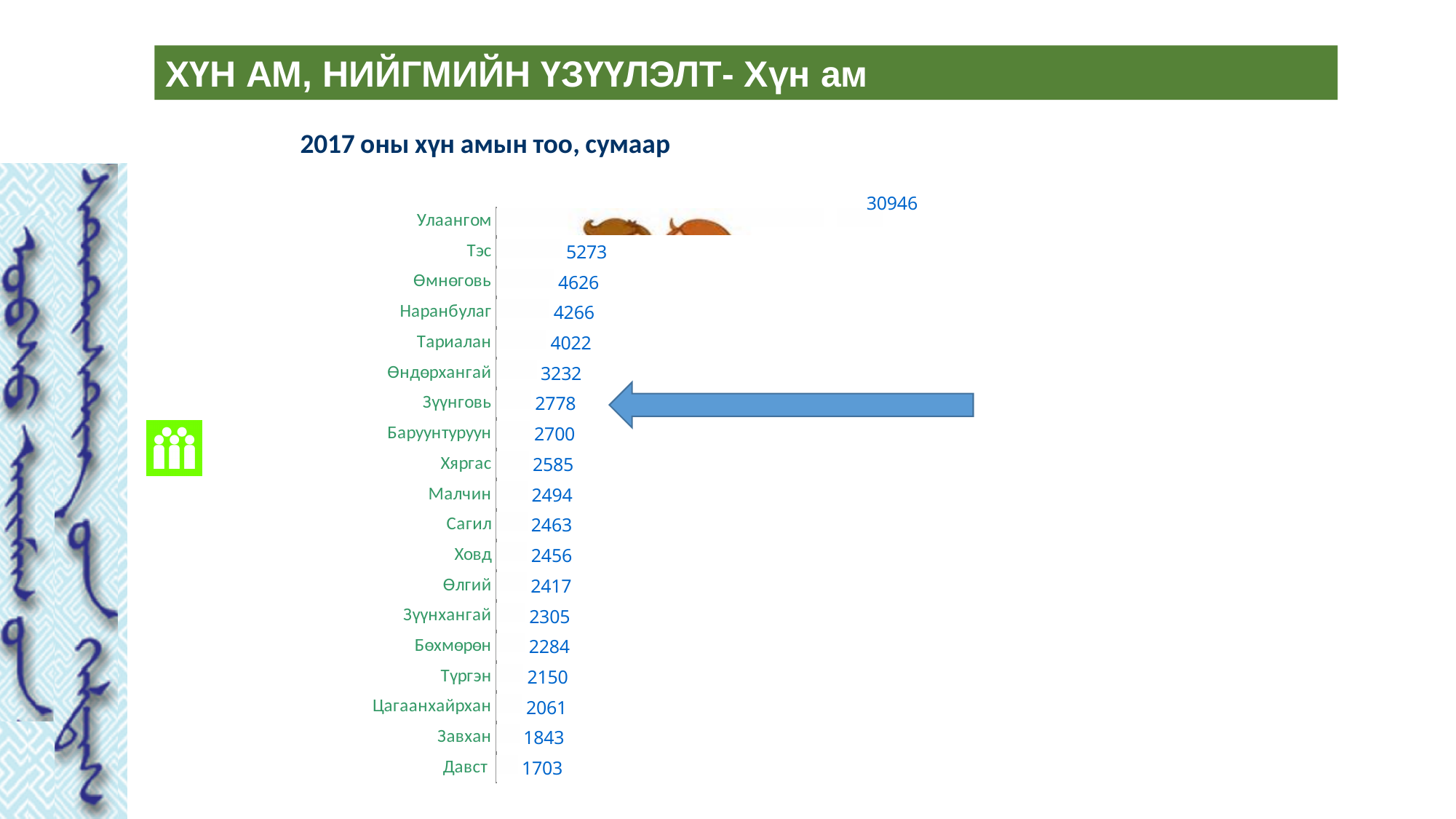
What is the value shown for Тариалан? 4022 Which has a larger value, Наранбулаг or Өндөрхангай? Наранбулаг What kind of chart is shown on the slide? Bar chart What is the difference between the values for Завхан and Давст? 140 How many categories (soums) are listed on the chart? 19 Which category has the lowest value on the chart? Давст What is the title of the chart? 2017 оны хүн амын тоо, сумаар What is the value shown for Давст? 1703 What is the value shown for Зүүнговь, the category the arrow points to? 2778 What is the difference between the values for Тэс and Өмнөговь? 647 What is the population value shown for Улаангом? 30946 Which category has the highest value on the chart? Улаангом